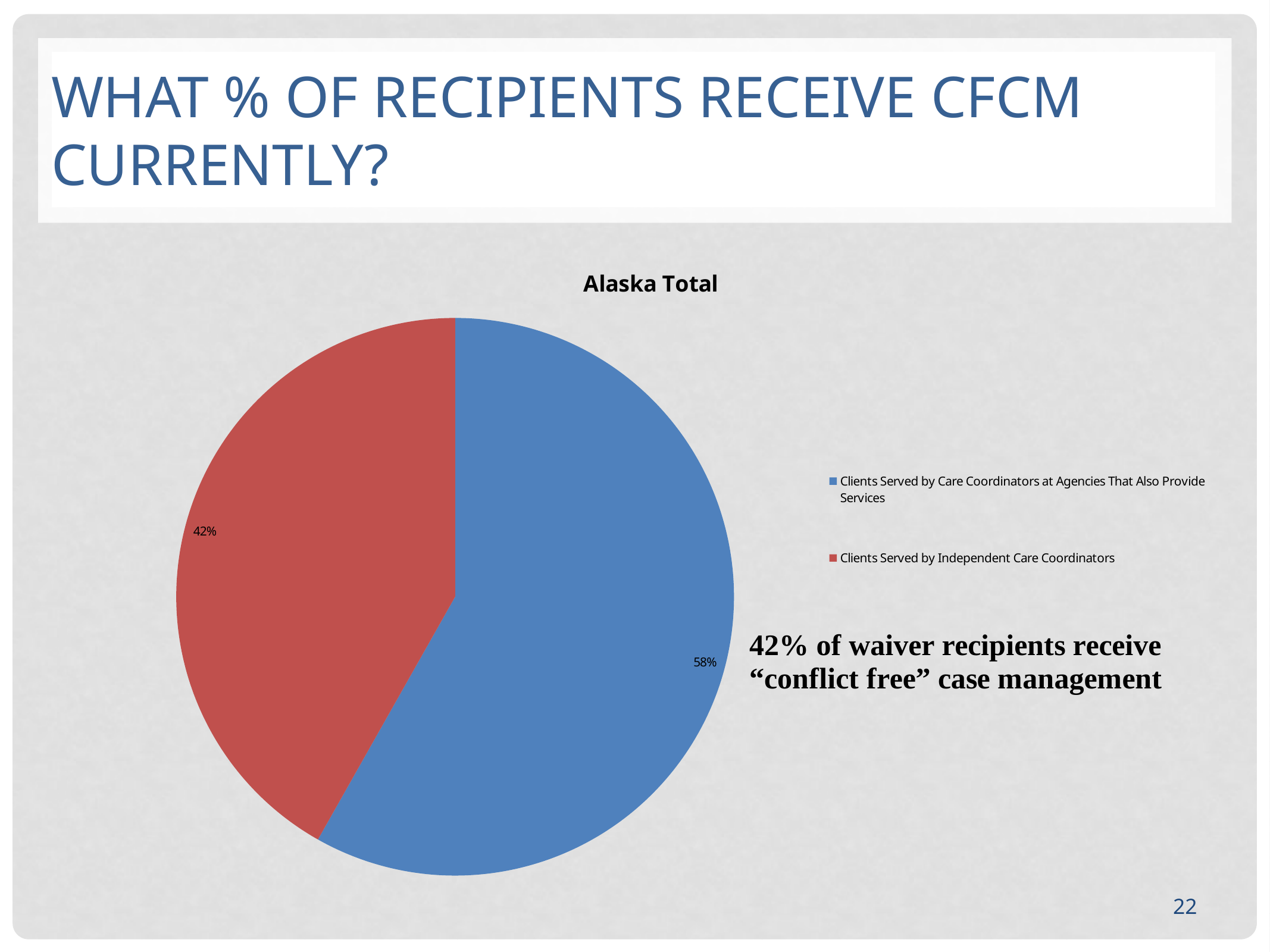
Which slice of the pie is the smallest? Clients Served by Independent Care Coordinators What kind of chart is shown on the slide? Pie chart Which slice of the pie is the largest? Clients Served by Care Coordinators at Agencies That Also Provide Services Which is larger: the share for Clients Served by Independent Care Coordinators or the share for Clients Served by Care Coordinators at Agencies That Also Provide Services? Clients Served by Care Coordinators at Agencies That Also Provide Services What is the title of the chart? Alaska Total What is the difference in percentage points between the two slices of the pie? 16 How many slices does the pie chart have? 2 How many entries does the legend list? 2 Is the share for Clients Served by Care Coordinators at Agencies That Also Provide Services greater or less than 50%? greater What share of the pie is Clients Served by Independent Care Coordinators? 42% What share of the pie is Clients Served by Care Coordinators at Agencies That Also Provide Services? 58% What colour is the slice for Clients Served by Independent Care Coordinators? Red